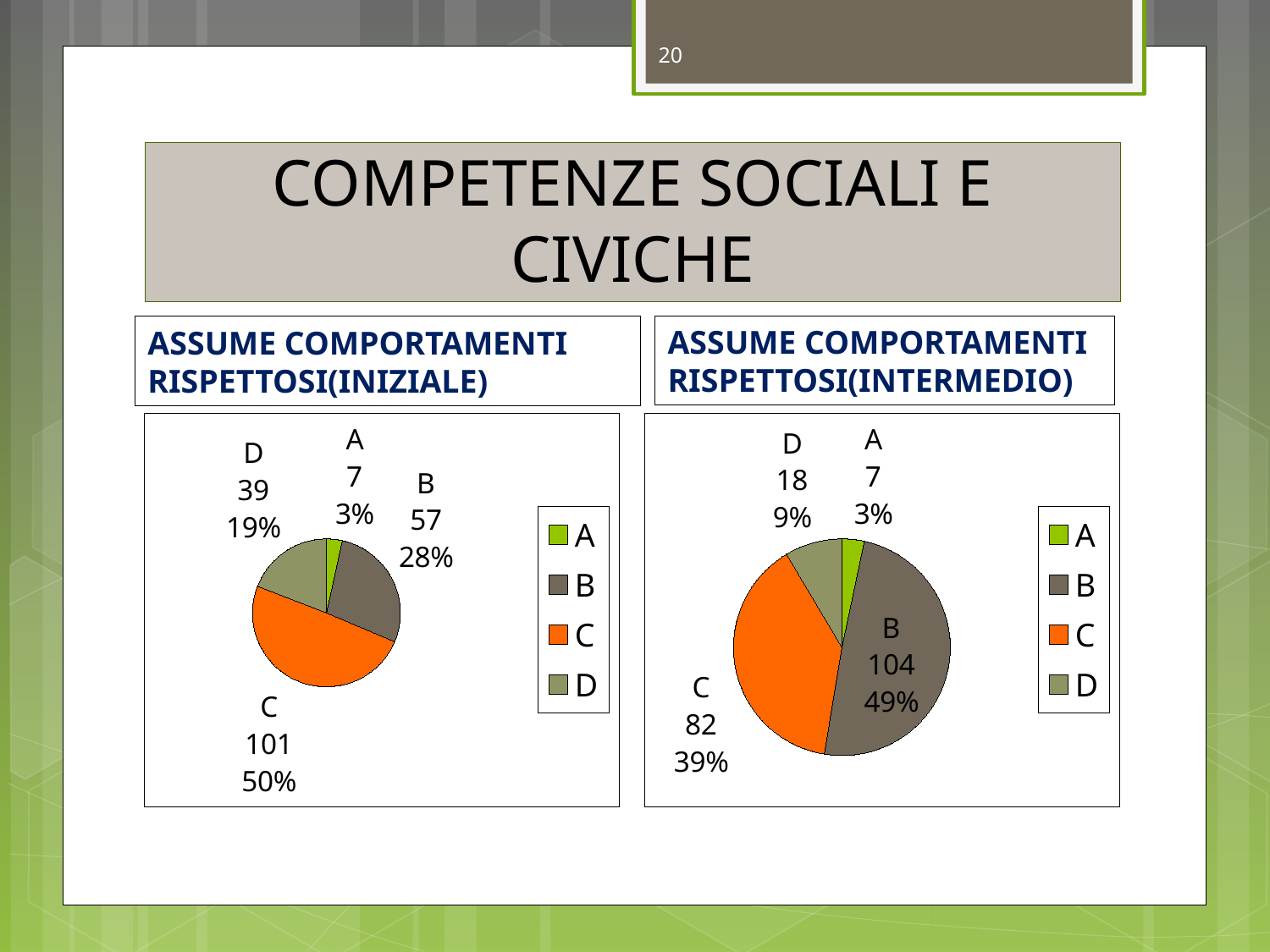
How many categories does the left pie chart (INIZIALE) show? 4 What is the title of the chart on the left side of the slide? ASSUME COMPORTAMENTI RISPETTOSI(INIZIALE) In the left pie chart (INIZIALE), what is the value for category C? 101 In the right pie chart (INTERMEDIO), what is the value for category B? 104 In the left pie chart (INIZIALE), which category has the largest slice? C In the right pie chart (INTERMEDIO), what colour is the slice for category C? Orange In the left pie chart (INIZIALE), which is larger, the value for B or the value for D? B In the right pie chart (INTERMEDIO), what is the difference between the values for B and C? 22 In the left pie chart (INIZIALE), what percentage share does category D have? 19% In the right pie chart (INTERMEDIO), which category has the smallest slice? A In the right pie chart (INTERMEDIO), what percentage share does category C have? 39% What type of chart is used on the right side of the slide (INTERMEDIO)? Pie chart